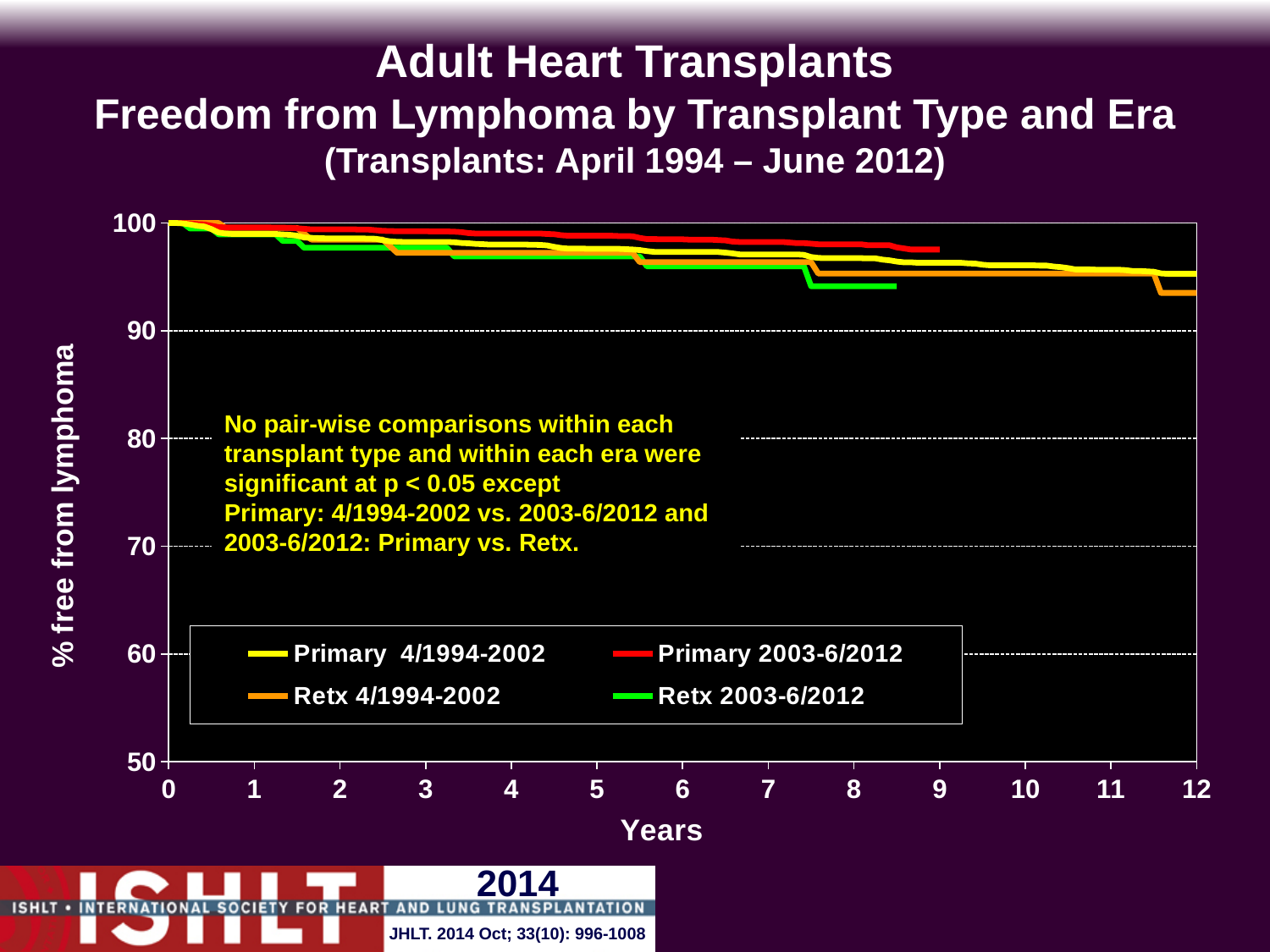
What is the label of the y axis? % free from lymphoma Is the value for Retx 4/1994-2002 at year 12 greater or less than 90? greater At year 8, which series is higher: Primary 2003-6/2012 or Retx 2003-6/2012? Primary 2003-6/2012 What kind of chart is shown on the slide? line chart Is the value for Retx 2003-6/2012 at year 8 greater or less than 90? greater How many series does the legend list? 4 Which series ends earliest along the x axis? Retx 2003-6/2012 What value do all four curves start at in year 0? 100 At year 8, which series is lowest? Retx 2003-6/2012 Do the curves rise or fall as the years increase? fall Is the value for Primary 2003-6/2012 at year 9 greater or less than 90? greater What are the four series listed in the legend? Primary 4/1994-2002, Primary 2003-6/2012, Retx 4/1994-2002, Retx 2003-6/2012